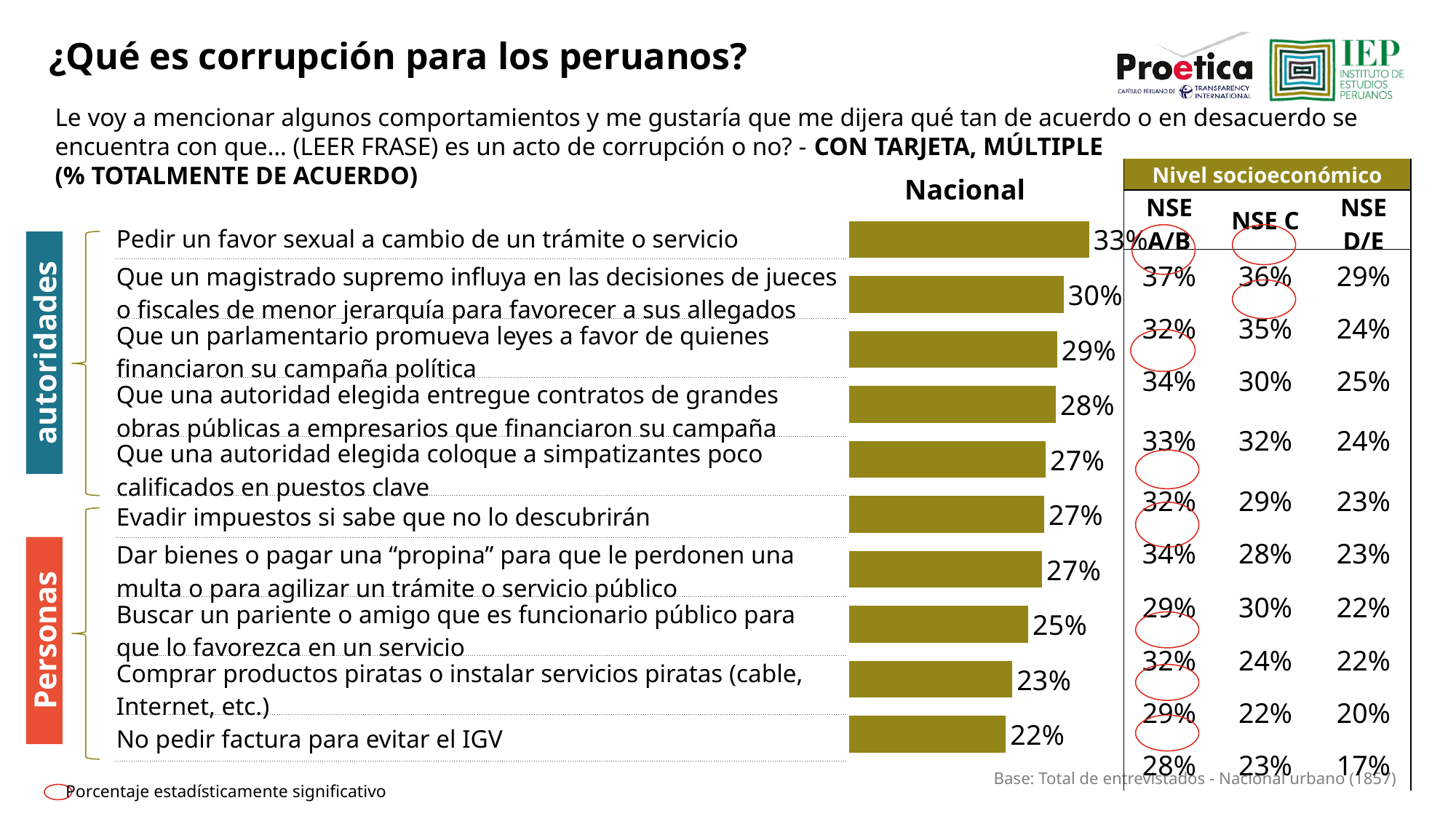
What is the difference between the Nacional values for "Que un magistrado supremo influya en las decisiones de jueces o fiscales de menor jerarquía para favorecer a sus allegados" and "Comprar productos piratas o instalar servicios piratas (cable, Internet, etc.)"? 7% What type of chart is used to show the Nacional percentages? Bar chart What is the difference between the Nacional values for "Pedir un favor sexual a cambio de un trámite o servicio" and "No pedir factura para evitar el IGV"? 11% What is the Nacional value for "Evadir impuestos si sabe que no lo descubrirán"? 27% Do the Nacional values increase or decrease from the top bar to the bottom bar? Decrease What is the Nacional value for "Buscar un pariente o amigo que es funcionario público para que lo favorezca en un servicio"? 25% What is the Nacional value for "Pedir un favor sexual a cambio de un trámite o servicio"? 33% What is the Nacional value for "No pedir factura para evitar el IGV"? 22% Which has a higher Nacional value: "Que un parlamentario promueva leyes a favor de quienes financiaron su campaña política" or "Comprar productos piratas o instalar servicios piratas (cable, Internet, etc.)"? Que un parlamentario promueva leyes a favor de quienes financiaron su campaña política Which behaviour has the lowest Nacional percentage in the bar chart? No pedir factura para evitar el IGV How many behaviours (bars) are shown in the Nacional bar chart? 10 Which behaviour has the highest Nacional percentage in the bar chart? Pedir un favor sexual a cambio de un trámite o servicio